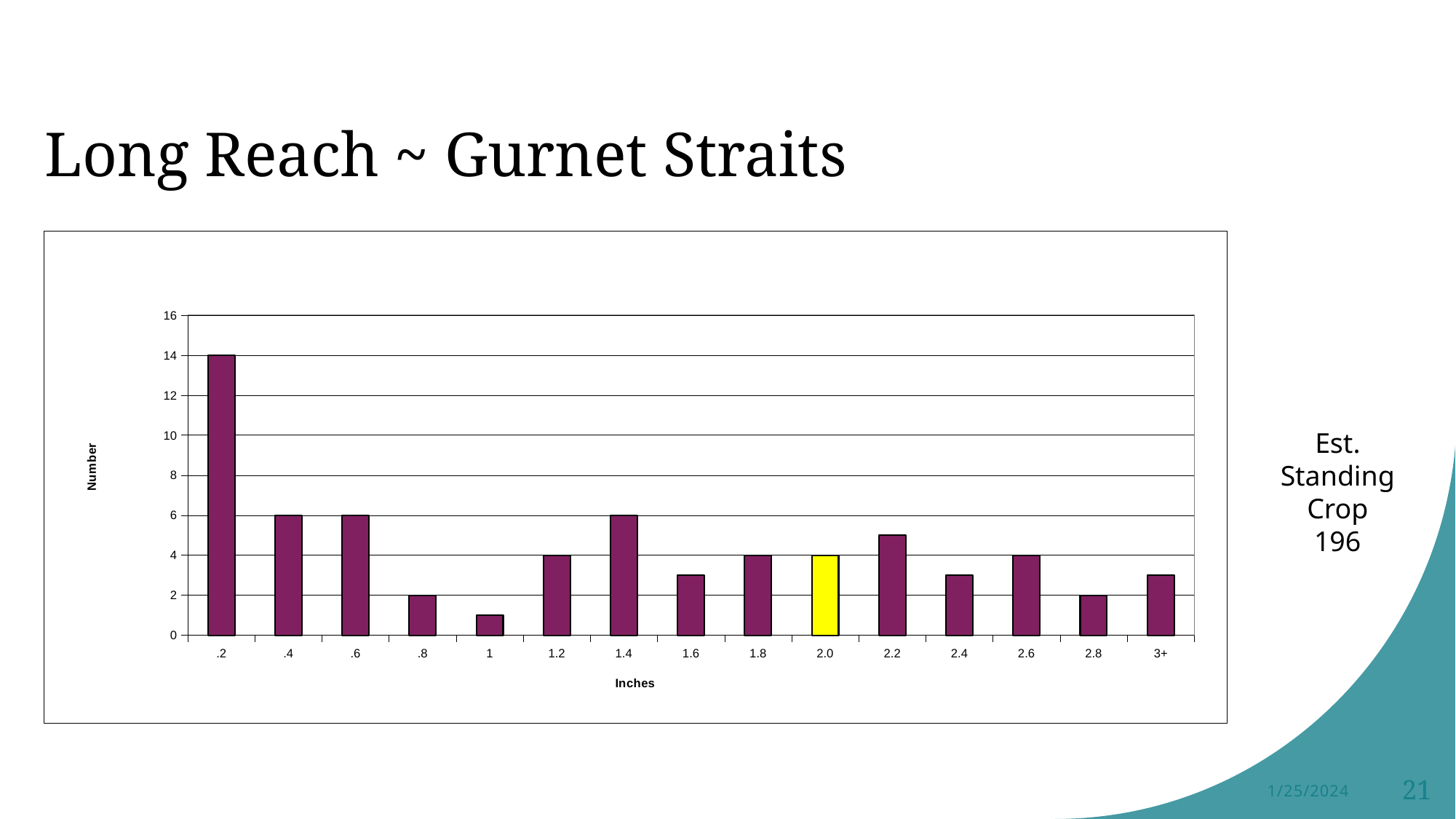
How many inch categories are shown on the x axis? 15 Which inch category has the highest value? .2 What is the value for the .2 inch category? 14 What is the value for the 2.0 inch category? 4 What is the value for the 2.8 inch category? 2 Which is larger, the value for .6 inches or the value for .8 inches? .6 What kind of chart is shown on the slide? bar chart Which inch category has the lowest value? 1 What is the difference between the values for .2 and .4 inches? 8 Which inch category is highlighted with a yellow bar? 2.0 What is the value for the .4 inch category? 6 Is the value for 2.2 inches greater or less than 4? greater